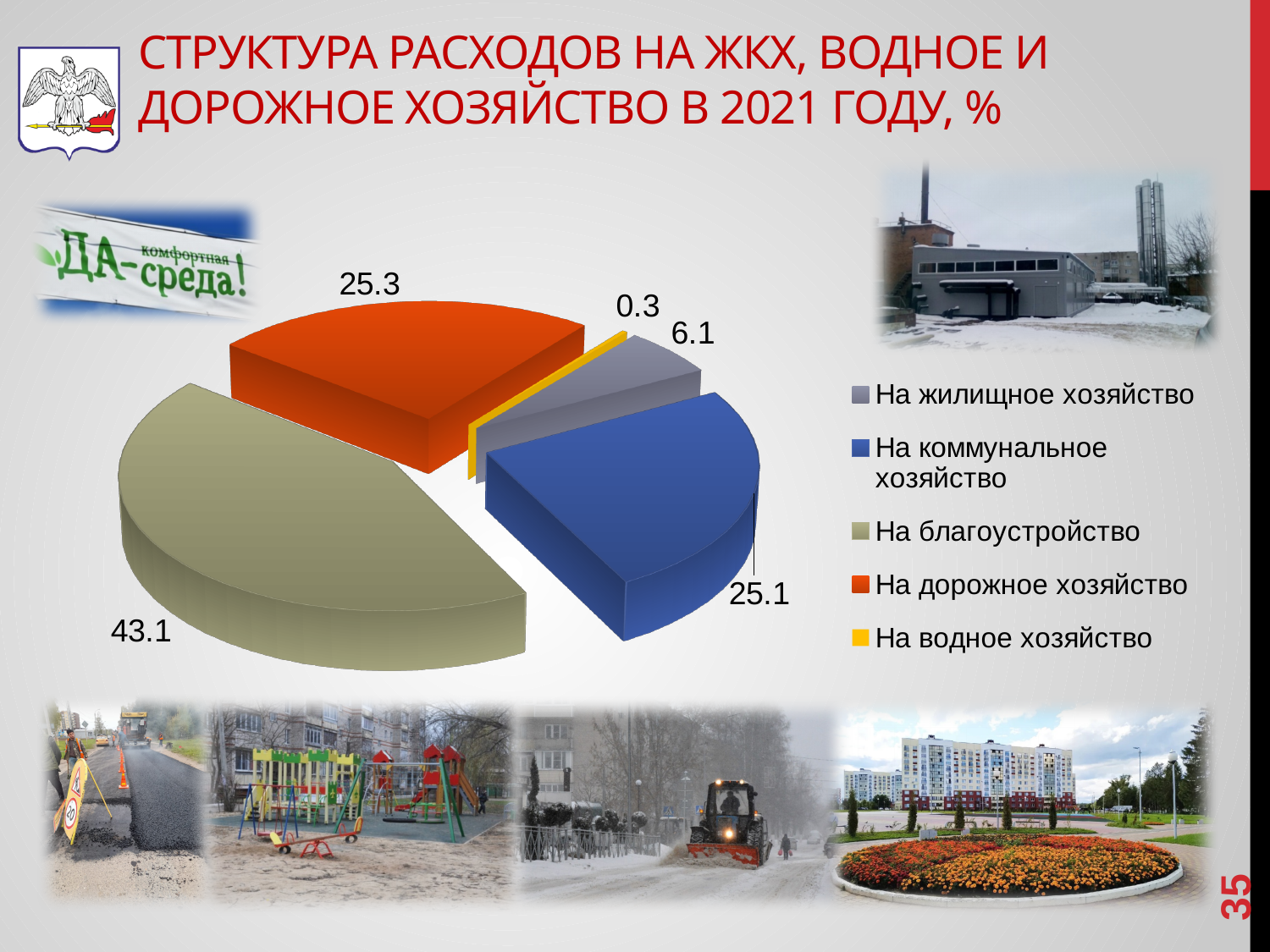
Which is larger, the value for На дорожное хозяйство or the value for На жилищное хозяйство? На дорожное хозяйство What is the value for На водное хозяйство? 0.3 Which category has the largest share of the pie? На благоустройство What is the difference between the values for На благоустройство and На коммунальное хозяйство? 18.0 How many categories does the legend list? 5 What kind of chart is shown on the slide? pie chart What is the value for На благоустройство? 43.1 What colour is the slice for На коммунальное хозяйство? blue What is the value for На коммунальное хозяйство? 25.1 What is the value for На жилищное хозяйство? 6.1 What is the value for На дорожное хозяйство? 25.3 Which category has the smallest share of the pie? На водное хозяйство